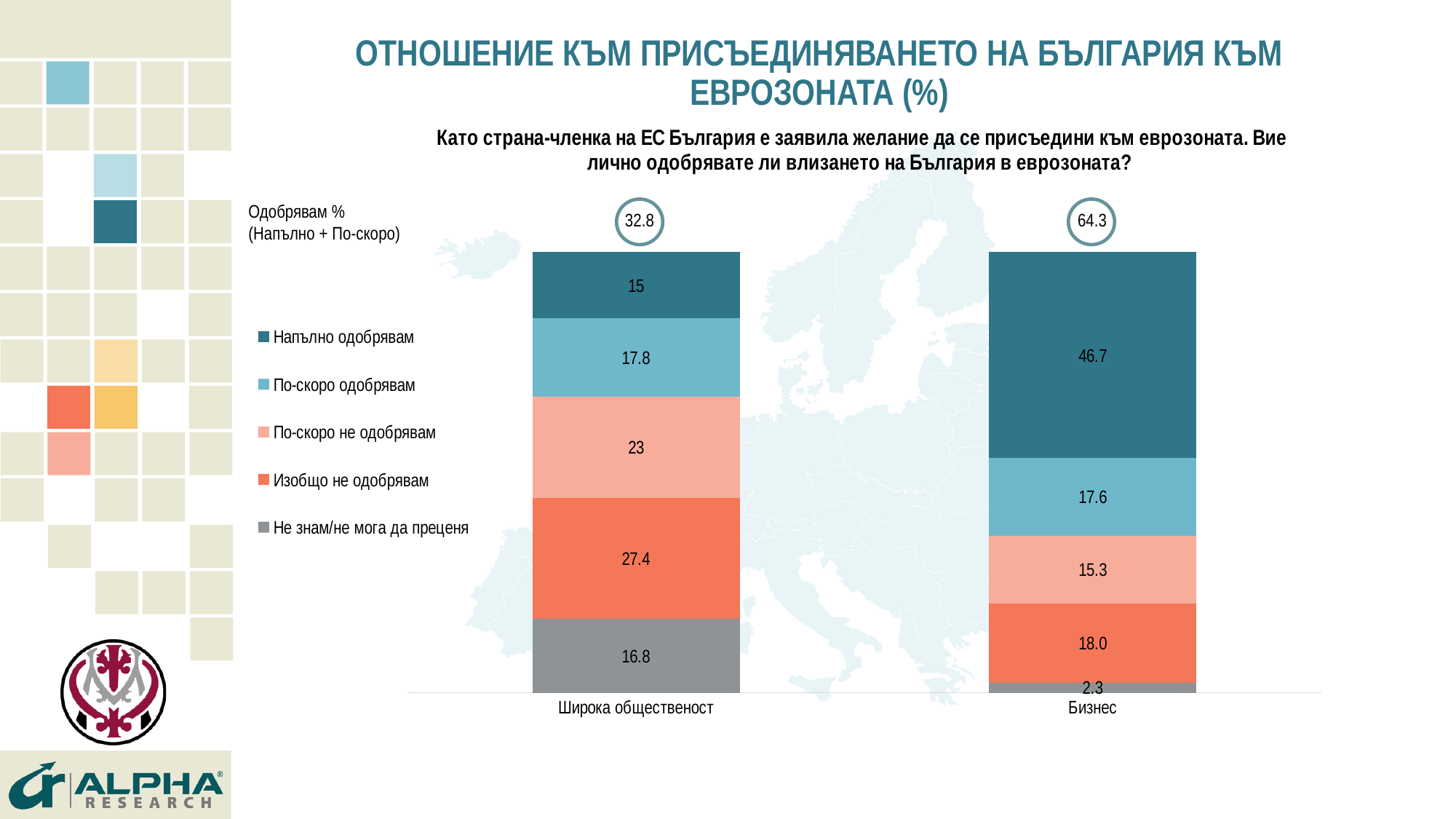
Which segment is the smallest in the "Бизнес" bar? Не знам/не мога да преценя What is the value for "По-скоро не одобрявам" in the "Широка общественост" bar? 23 What is the value for "Напълно одобрявам" in the "Бизнес" bar? 46.7 What kind of chart is shown on the slide? stacked bar chart What combined approval share (Напълно + По-скоро) is shown in the circle above the "Бизнес" bar? 64.3 What is the value for "Изобщо не одобрявам" in the "Широка общественост" bar? 27.4 What is the value for "Не знам/не мога да преценя" in the "Бизнес" bar? 2.3 How many series does the legend list? 5 What is the difference between the "Напълно одобрявам" values for "Бизнес" and "Широка общественост"? 31.7 Which category has the larger value for "Изобщо не одобрявам", "Широка общественост" or "Бизнес"? Широка общественост How many categories are shown on the x axis of the chart? 2 Which segment is the largest in the "Широка общественост" bar? Изобщо не одобрявам